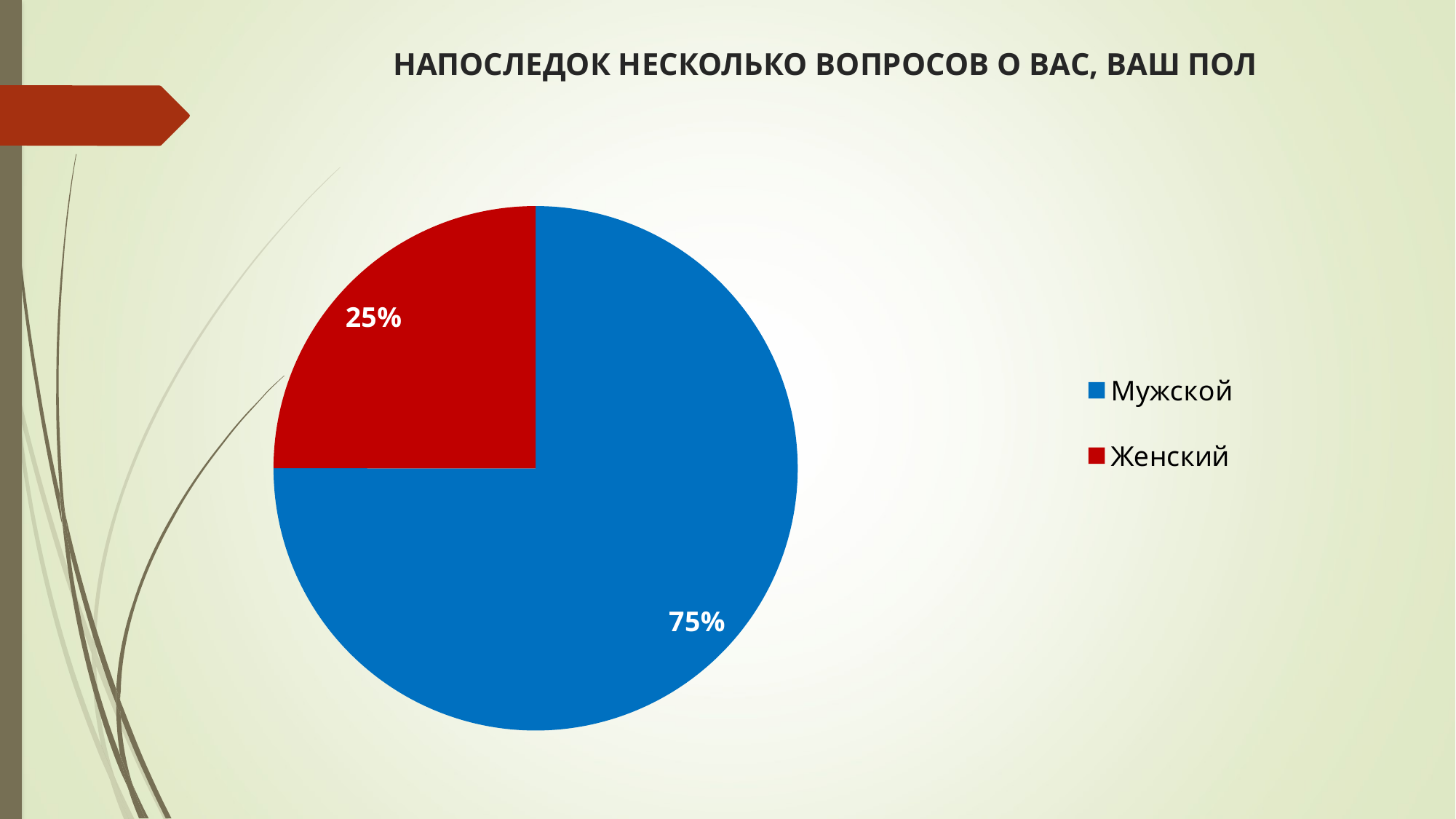
What is the difference in percentage points between the Мужской and Женский slices? 50 Which category has the smallest slice of the pie? Женский What colour is the Женский slice? Red What kind of chart is shown on the slide? Pie chart What share of the pie is labelled Мужской? 75% What share of the pie is labelled Женский? 25% Which category has the largest slice of the pie? Мужской What is the title of the chart? НАПОСЛЕДОК НЕСКОЛЬКО ВОПРОСОВ О ВАС, ВАШ ПОЛ How many slices does the pie chart have? 2 How many entries does the legend list? 2 Which slice is larger, Мужской or Женский? Мужской